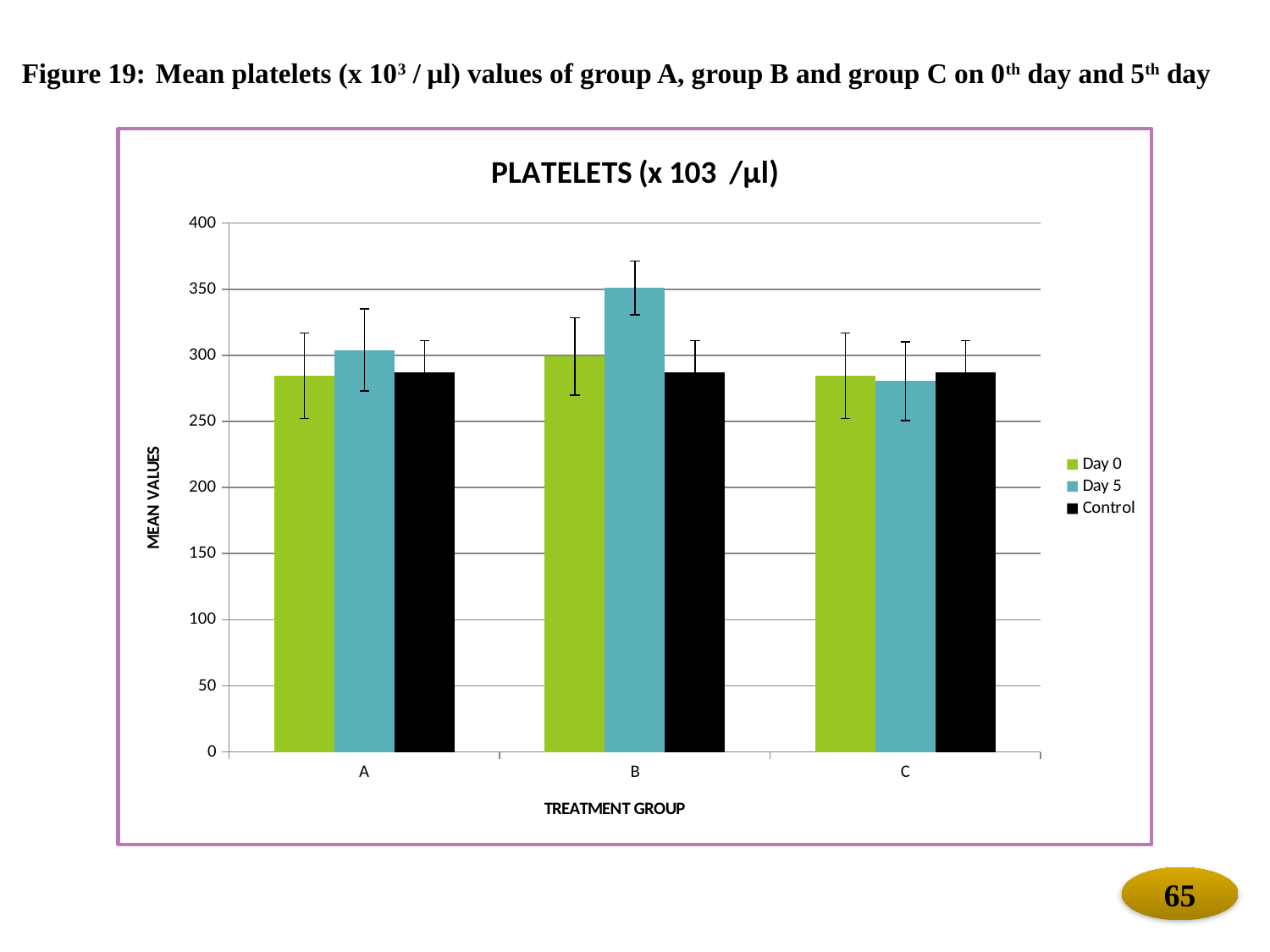
Is the Day 5 value for group C greater or less than 300? less Is the Day 0 value for group A greater or less than 250? greater What kind of chart is shown on the slide? bar chart Which treatment group has the highest Day 5 value? B In group B, which is larger: the Day 0 value or the Day 5 value? Day 5 How many treatment groups are shown on the x axis? 3 Which treatment group has the lowest Day 5 value? C How many series does the legend list? 3 What is the label of the x axis? TREATMENT GROUP Which is larger: the Day 5 value for group B or the Day 5 value for group C? group B Is the Day 5 value for group B greater or less than 300? greater